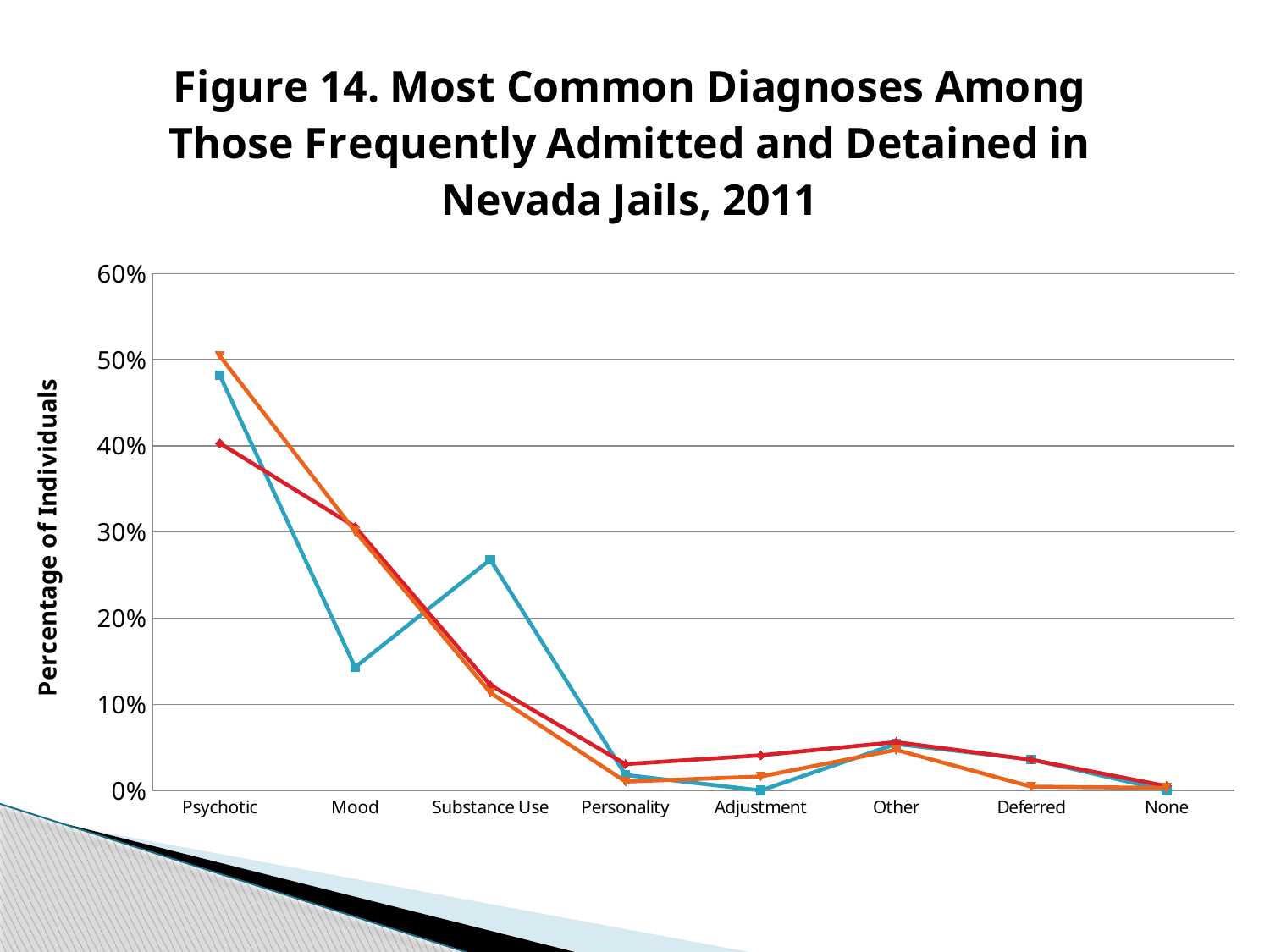
Is the value of the blue line for Psychotic greater or less than 40%? greater What is the label on the vertical axis? Percentage of Individuals At Psychotic, which line has the larger value: the orange line or the red line? orange What kind of chart is shown on the slide? line chart How many lines are plotted on the chart? 3 Which category has the highest value for the blue line? Psychotic How many diagnosis categories are shown on the x axis? 8 Is the value of the red line for Other greater or less than 10%? less For the blue line, which is larger: the value for Mood or the value for Substance Use? Substance Use Is the value of the blue line for Mood greater or less than 20%? less Which category has the highest value for the orange line? Psychotic